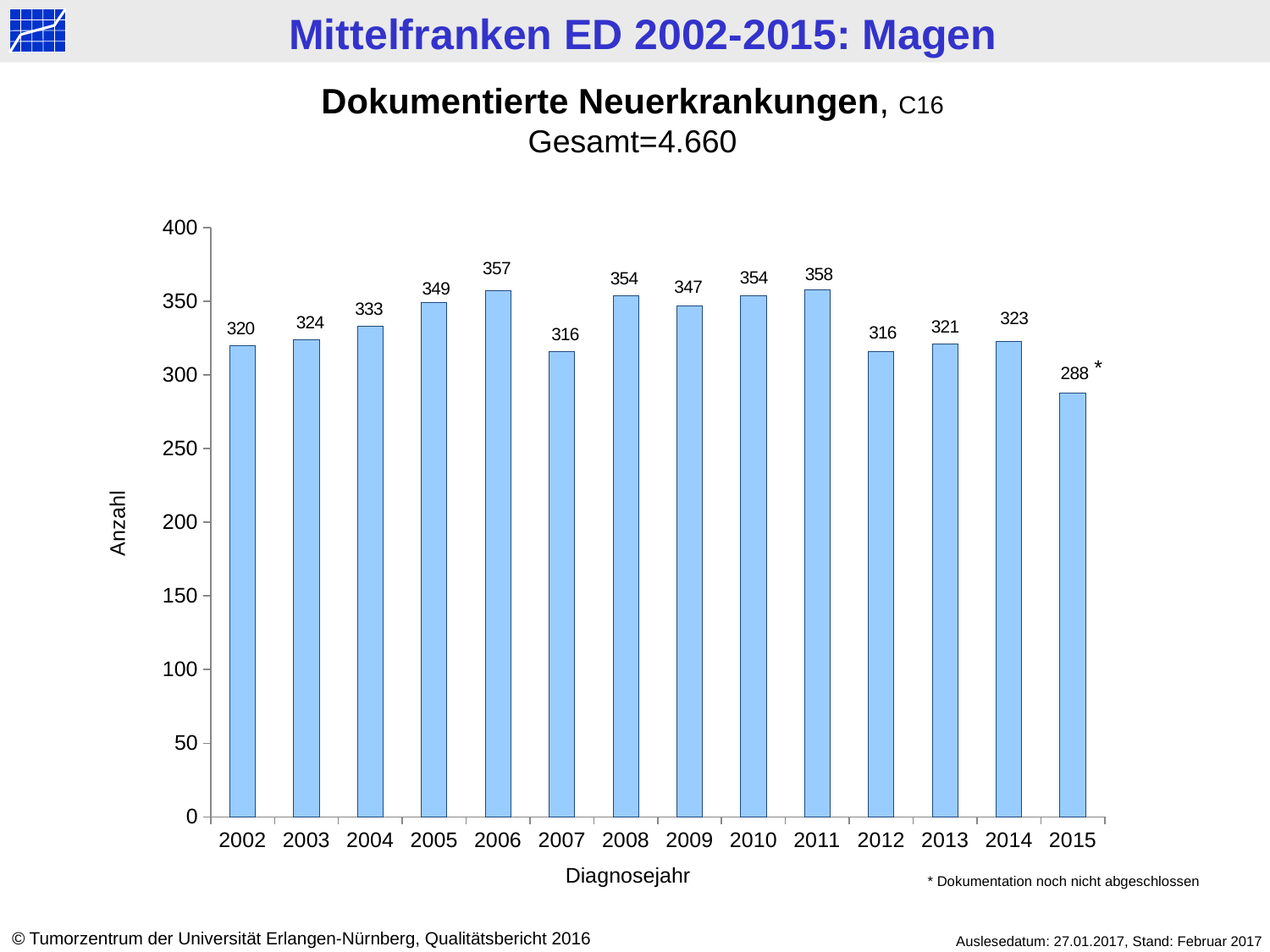
What is the value for 2012? 316 What is the label of the y axis? Anzahl What is the value for 2015? 288 What is the difference between the values for 2011 and 2015? 70 Do the values rise or fall from 2002 to 2006? rise Which is larger, the value for 2005 or the value for 2009? 2009 Which year has the highest value? 2011 What is the value for 2006? 357 Which year has the lowest value? 2015 Is the value for 2015 greater or less than 300? less What kind of chart is shown? bar chart How many years are shown on the x axis? 14